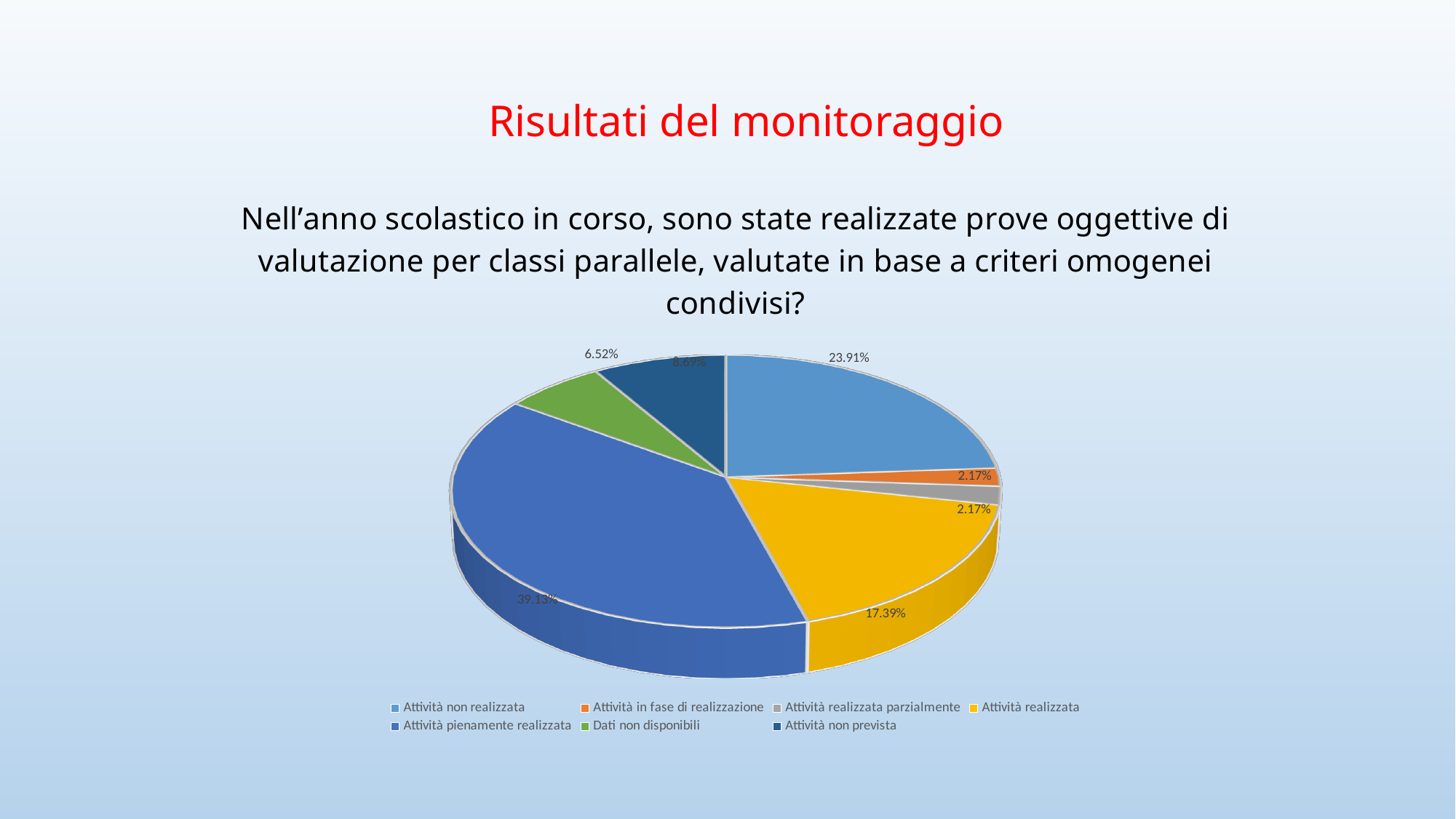
What kind of chart is shown on the slide? pie chart What is the difference in percentage points between the Attività pienamente realizzata slice and the Attività non realizzata slice? 15.22 What share of the pie is labelled for Attività pienamente realizzata? 39.13% What colour is the slice for Attività realizzata? yellow What share of the pie is labelled for Dati non disponibili? 6.52% What share of the pie is labelled for Attività non realizzata? 23.91% How many entries does the legend list? 7 Which category has the largest slice of the pie? Attività pienamente realizzata Which is larger, the slice for Attività non realizzata or the slice for Attività realizzata? Attività non realizzata What share of the pie is labelled for Attività in fase di realizzazione? 2.17% How many slices does the pie chart have? 7 What share of the pie is labelled for Attività realizzata? 17.39%